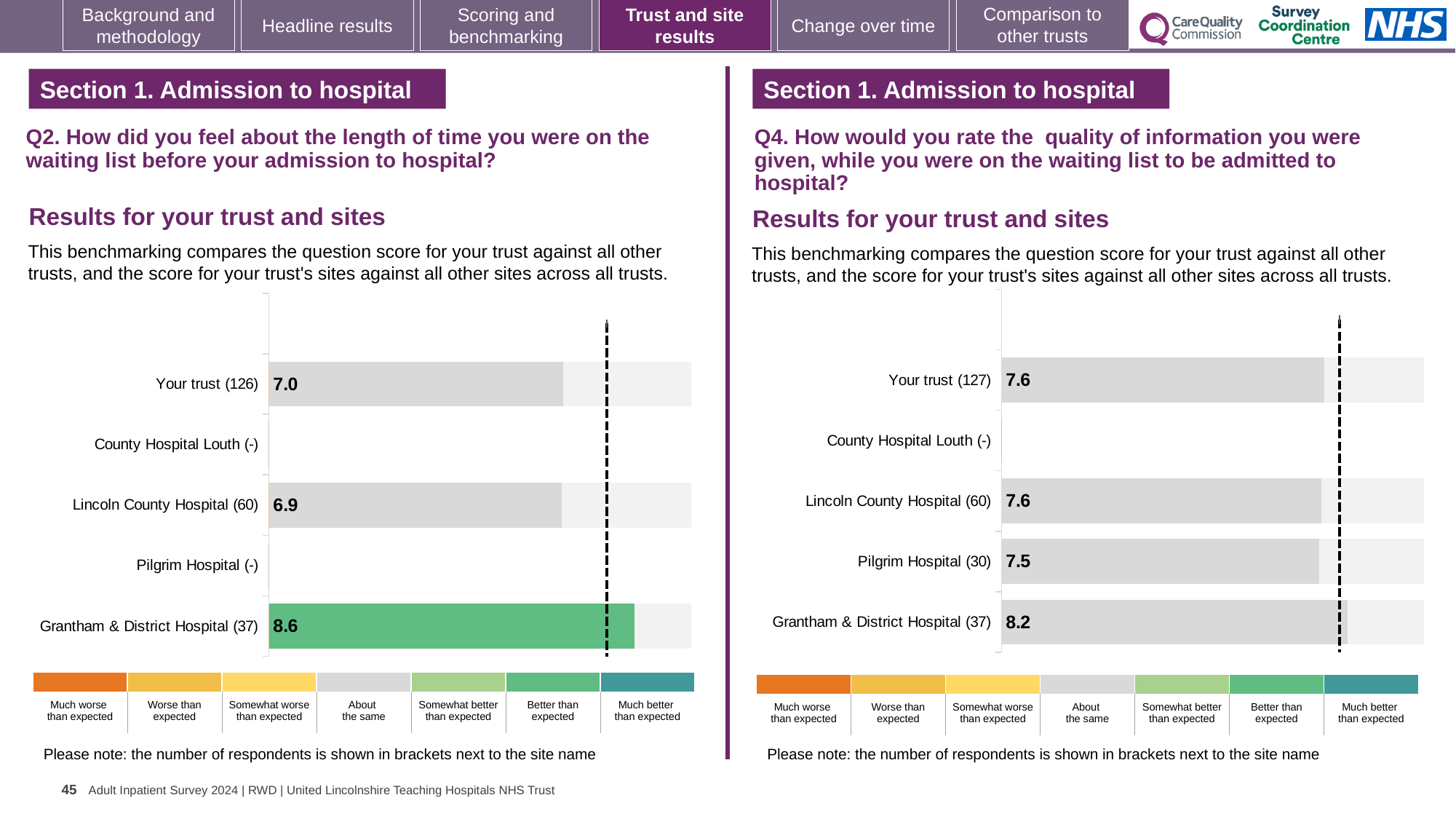
In the Q2 chart on the left, what is the score for Lincoln County Hospital (60)? 6.9 In the Q4 chart on the right, what is the score for Grantham & District Hospital (37)? 8.2 In the Q2 chart on the left, what is the difference between the scores for Grantham & District Hospital (37) and Your trust (126)? 1.6 In the Q2 chart on the left, what is the score for Your trust (126)? 7.0 What kind of chart is the Q2 chart on the left? Bar chart In the Q4 chart on the right, what is the difference between the scores for Grantham & District Hospital (37) and Lincoln County Hospital (60)? 0.6 In the Q4 chart on the right, what is the score for Pilgrim Hospital (30)? 7.5 In the Q2 chart on the left, which site has the highest score? Grantham & District Hospital (37) In the Q2 chart on the left, what colour is the bar for Grantham & District Hospital (37)? Green In the Q2 chart on the left, what is the score for Grantham & District Hospital (37)? 8.6 In the Q4 chart on the right, what is the score for Your trust (127)? 7.6 In the Q4 chart on the right, which site with a plotted score has the lowest score? Pilgrim Hospital (30)